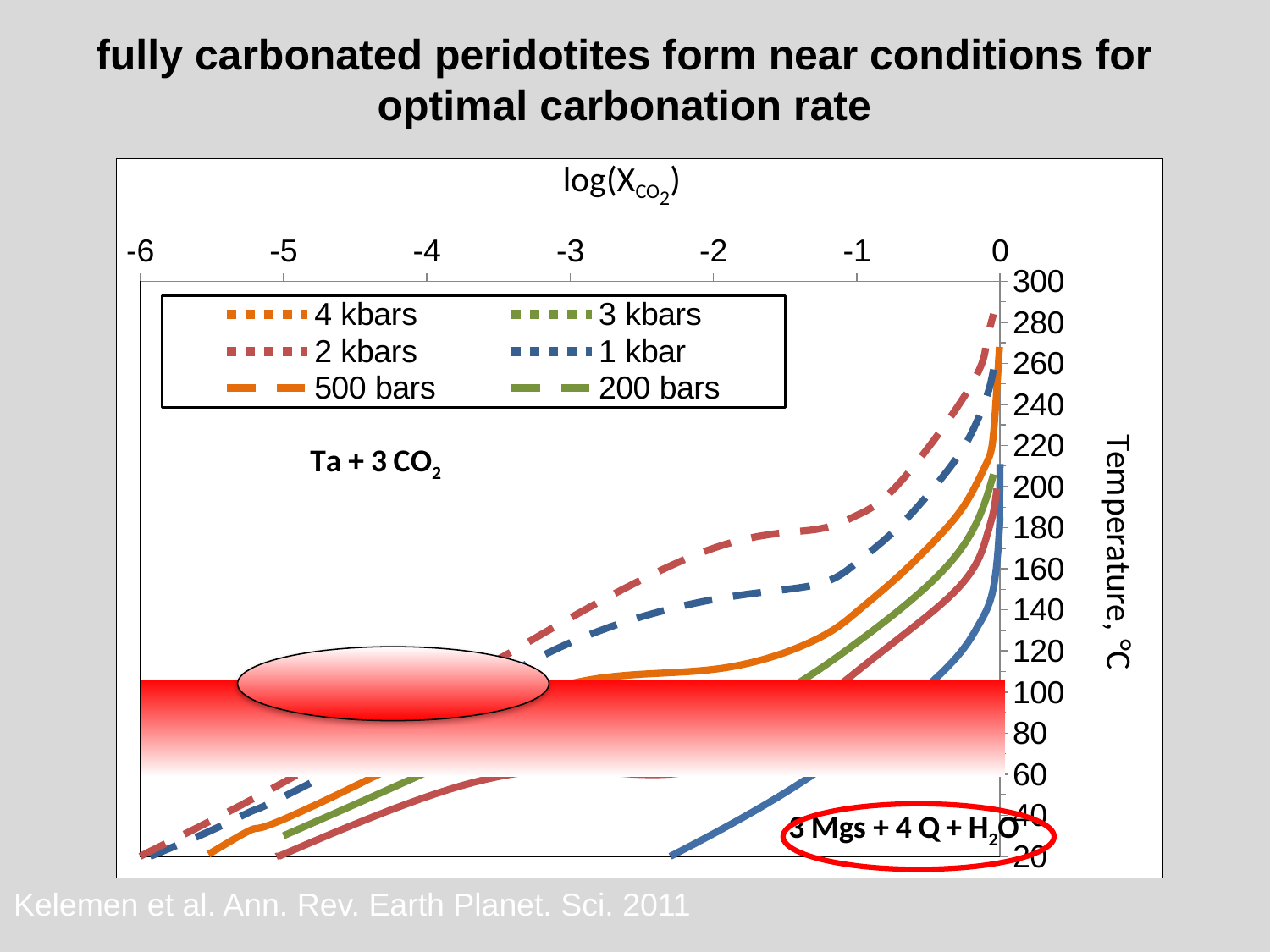
At log(XCO2) = -2, is the temperature on the 1 kbar curve greater or less than 120? greater As log(XCO2) increases from -3 toward 0, do the curves rise or fall in temperature? rise What is the highest temperature value labelled on the y axis? 300 What kind of chart is shown on the slide? line chart What is the title of the x axis? log(XCO2) How many series does the legend list? 6 How many tick labels are shown on the x axis? 7 What is the title of the y axis? Temperature, °C At log(XCO2) = -2, is the temperature on the 2 kbars curve greater or less than 140? greater At log(XCO2) = -1, which curve is at a higher temperature, 2 kbars or 1 kbar? 2 kbars At log(XCO2) = -1, is the temperature on the 500 bars curve greater or less than 120? greater